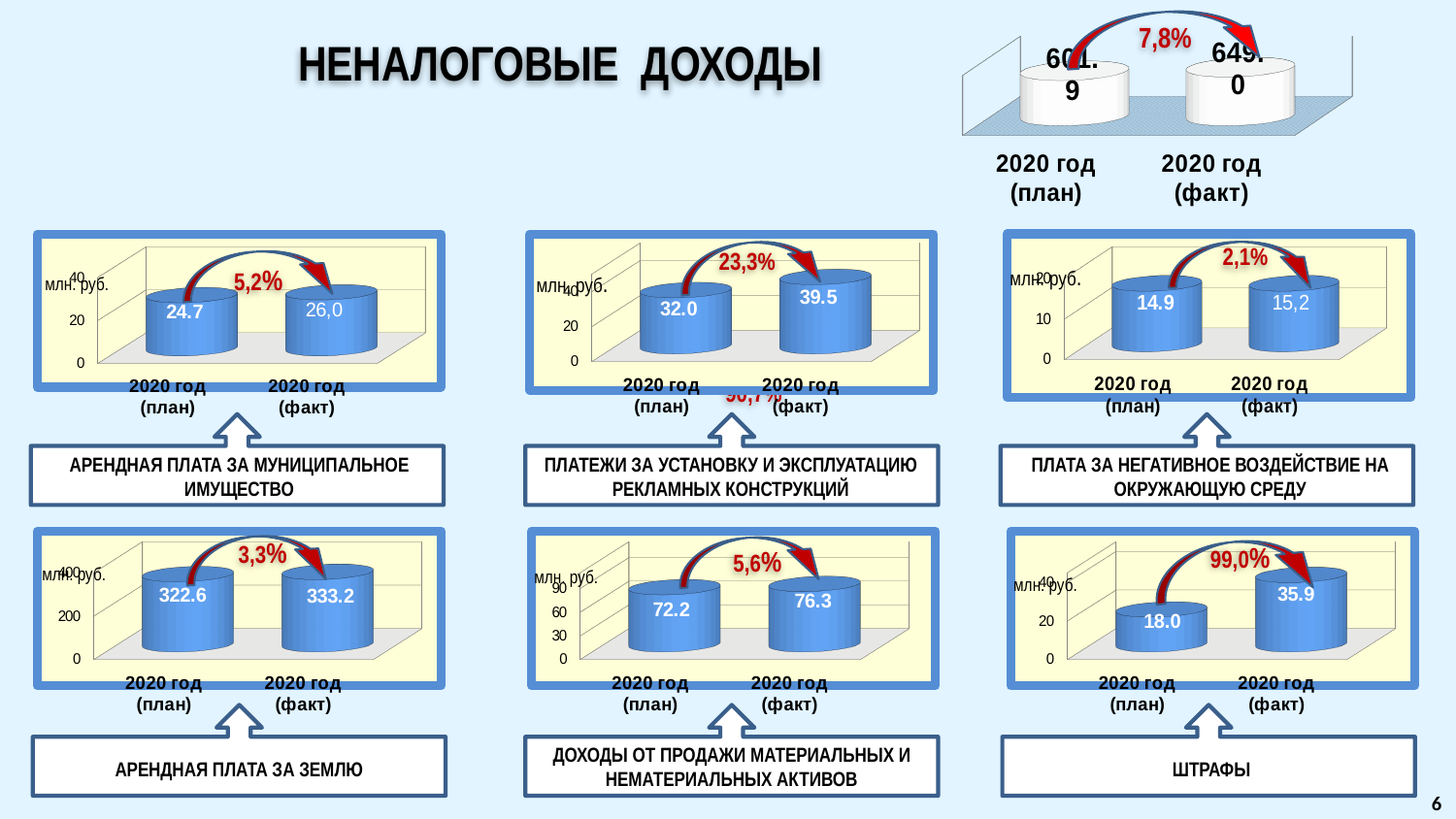
In the chart labelled «ШТРАФЫ», what percentage change is shown by the red arrow? 99,0% In the chart labelled «ПЛАТЕЖИ ЗА УСТАНОВКУ И ЭКСПЛУАТАЦИЮ РЕКЛАМНЫХ КОНСТРУКЦИЙ», what is the value for 2020 год (факт)? 39.5 In the chart labelled «ШТРАФЫ», what is the value for 2020 год (план)? 18.0 In the chart labelled «АРЕНДНАЯ ПЛАТА ЗА МУНИЦИПАЛЬНОЕ ИМУЩЕСТВО», do the values rise or fall from 2020 год (план) to 2020 год (факт)? rise In the chart labelled «ШТРАФЫ», which is larger: 2020 год (план) or 2020 год (факт)? 2020 год (факт) In the chart labelled «АРЕНДНАЯ ПЛАТА ЗА ЗЕМЛЮ», what is the value for 2020 год (факт)? 333.2 In the chart labelled «ПЛАТА ЗА НЕГАТИВНОЕ ВОЗДЕЙСТВИЕ НА ОКРУЖАЮЩУЮ СРЕДУ», what is the value for 2020 год (план)? 14.9 In the chart labelled «АРЕНДНАЯ ПЛАТА ЗА МУНИЦИПАЛЬНОЕ ИМУЩЕСТВО», what is the value for 2020 год (план)? 24.7 In the chart labelled «ДОХОДЫ ОТ ПРОДАЖИ МАТЕРИАЛЬНЫХ И НЕМАТЕРИАЛЬНЫХ АКТИВОВ», what is the difference between the 2020 год (факт) and 2020 год (план) values? 4.1 What kind of chart is the one labelled «ПЛАТА ЗА НЕГАТИВНОЕ ВОЗДЕЙСТВИЕ НА ОКРУЖАЮЩУЮ СРЕДУ»? bar chart How many bars does the chart labelled «АРЕНДНАЯ ПЛАТА ЗА ЗЕМЛЮ» contain? 2 In the chart labelled «ПЛАТЕЖИ ЗА УСТАНОВКУ И ЭКСПЛУАТАЦИЮ РЕКЛАМНЫХ КОНСТРУКЦИЙ», what percentage change is shown by the red arrow? 23,3%